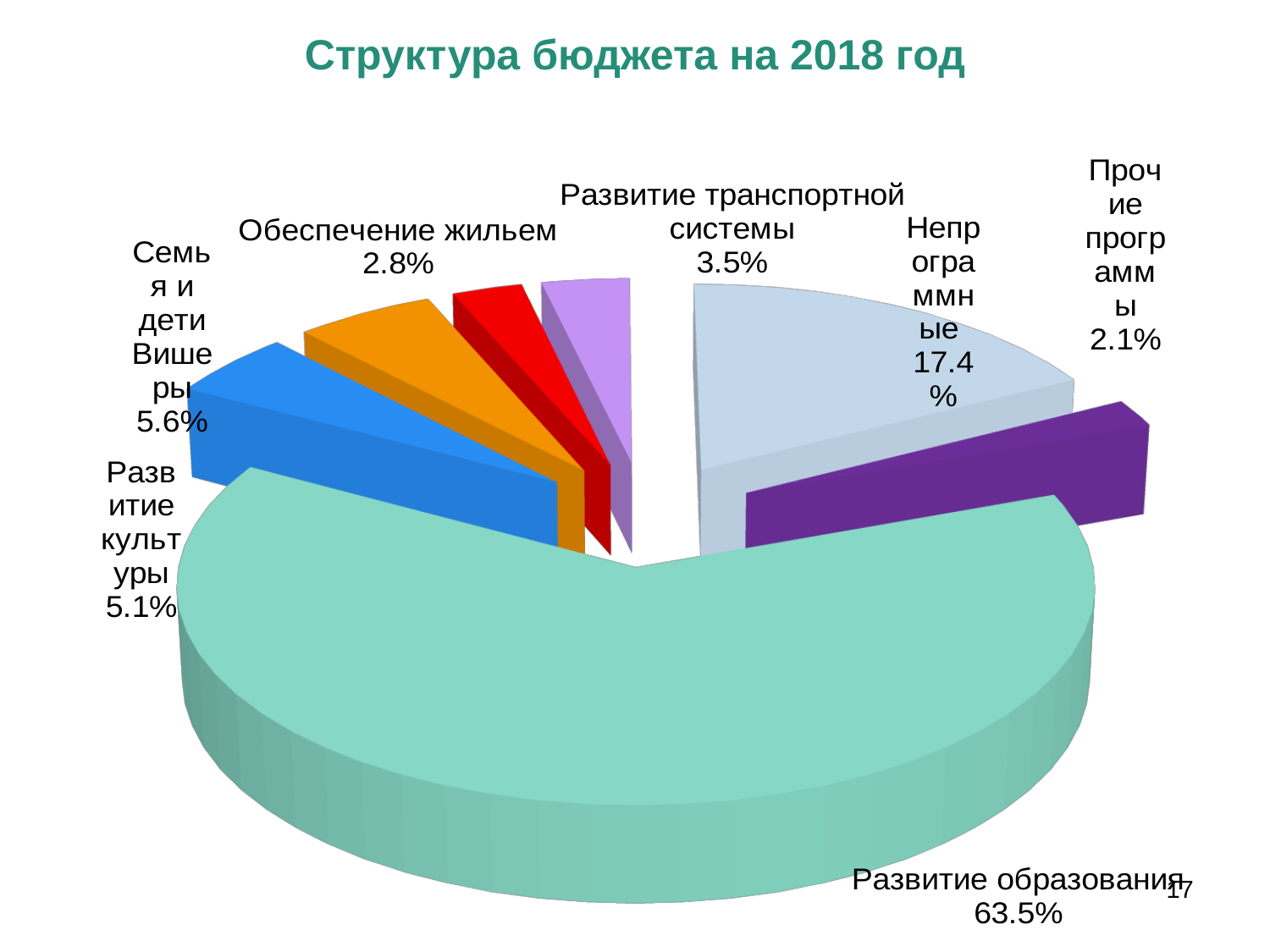
What share of the budget goes to Развитие образования? 63.5% Which category has the smallest share of the budget? Прочие программы Which is larger, the share for Развитие культуры or the share for Семья и дети Вишеры? Семья и дети Вишеры What is the title of the chart? Структура бюджета на 2018 год Which category has the largest share of the budget? Развитие образования What percentage is shown for Семья и дети Вишеры? 5.6% What kind of chart is shown on the slide? Pie chart What share of the budget is labelled Непрограммные? 17.4% What percentage is shown for Развитие транспортной системы? 3.5% What is the difference between the shares of Развитие образования and Непрограммные? 46.1% What percentage is shown for Обеспечение жильем? 2.8% How many slices does the pie chart have? 7